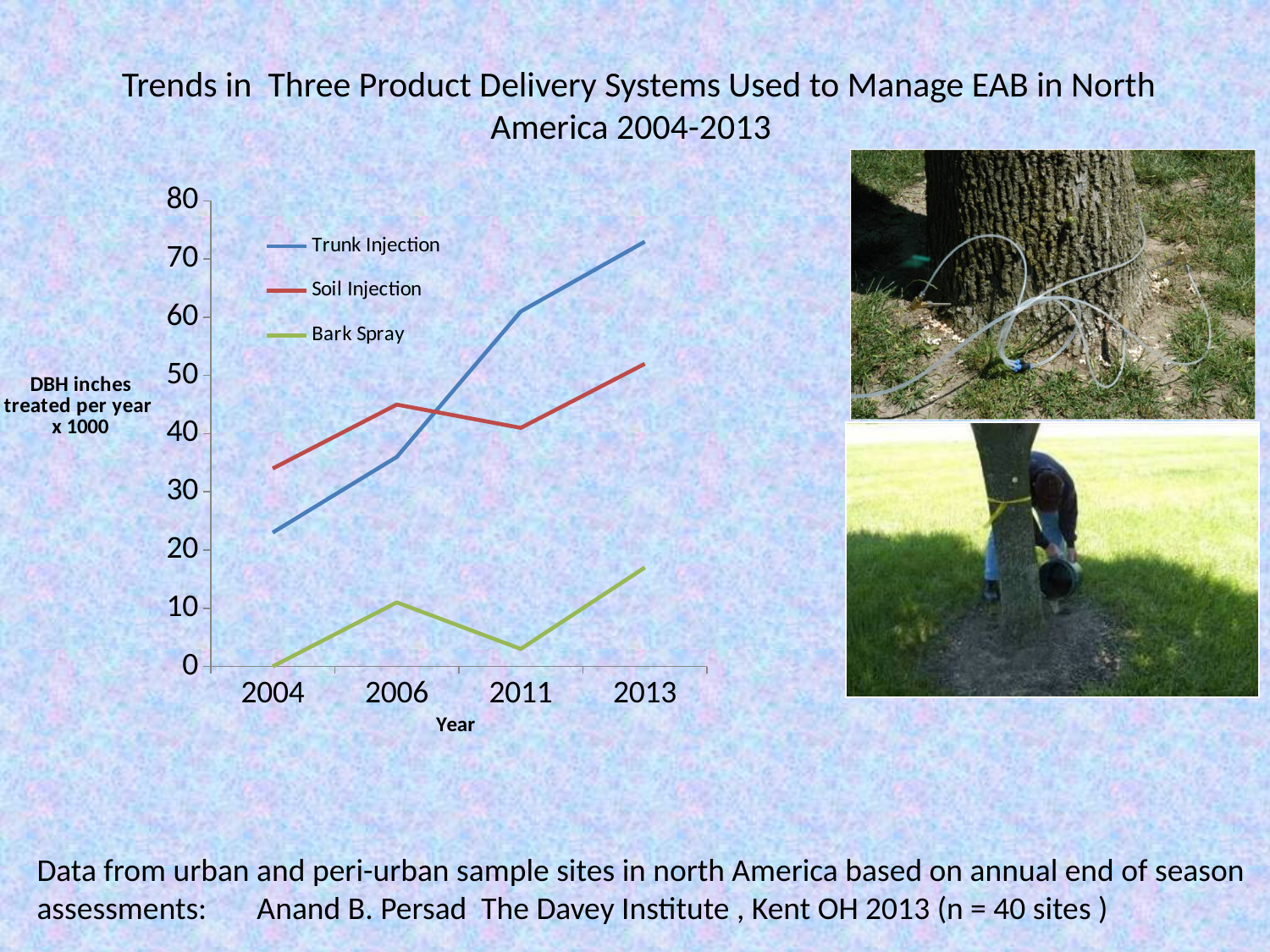
How many years are plotted along the x axis of the chart? 4 Does the Trunk Injection line rise or fall from 2004 to 2013? rises What is the value for Bark Spray in 2004? 0 What is the label on the x axis of the chart? Year What kind of chart is shown on the slide? line chart Which delivery system has the lowest value in 2013? Bark Spray Is the value for Soil Injection in 2011 greater or less than 50? less Which delivery system has the highest value in 2013? Trunk Injection Is the value for Trunk Injection in 2013 greater or less than 70? greater How many series does the chart's legend list? 3 In 2011, which is larger: Trunk Injection or Soil Injection? Trunk Injection In 2004, which is larger: Trunk Injection or Soil Injection? Soil Injection